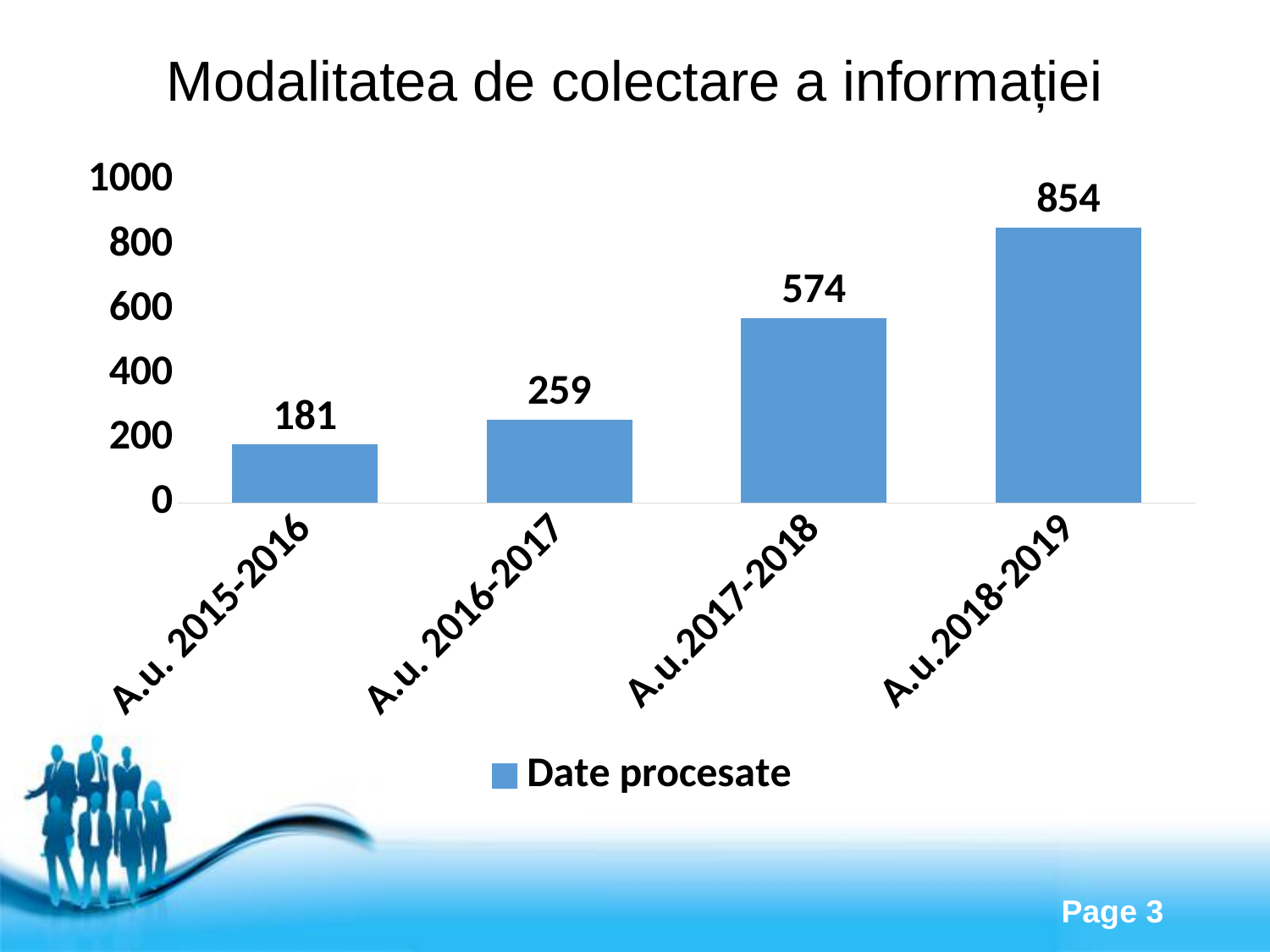
Which is larger, the value for A.u. 2016-2017 or the value for A.u.2017-2018? A.u.2017-2018 What is the difference between the values for A.u.2018-2019 and A.u.2017-2018? 280 What is the value for A.u. 2016-2017? 259 What is the value for A.u.2018-2019? 854 Which category has the lowest value? A.u. 2015-2016 Which category has the highest value? A.u.2018-2019 Is the value for A.u.2018-2019 greater or less than 800? greater What kind of chart is shown on the slide? bar chart What is the value for A.u. 2015-2016? 181 Do the values rise or fall from A.u. 2015-2016 to A.u.2018-2019? rise What is the value for A.u.2017-2018? 574 How many categories are shown on the x axis? 4